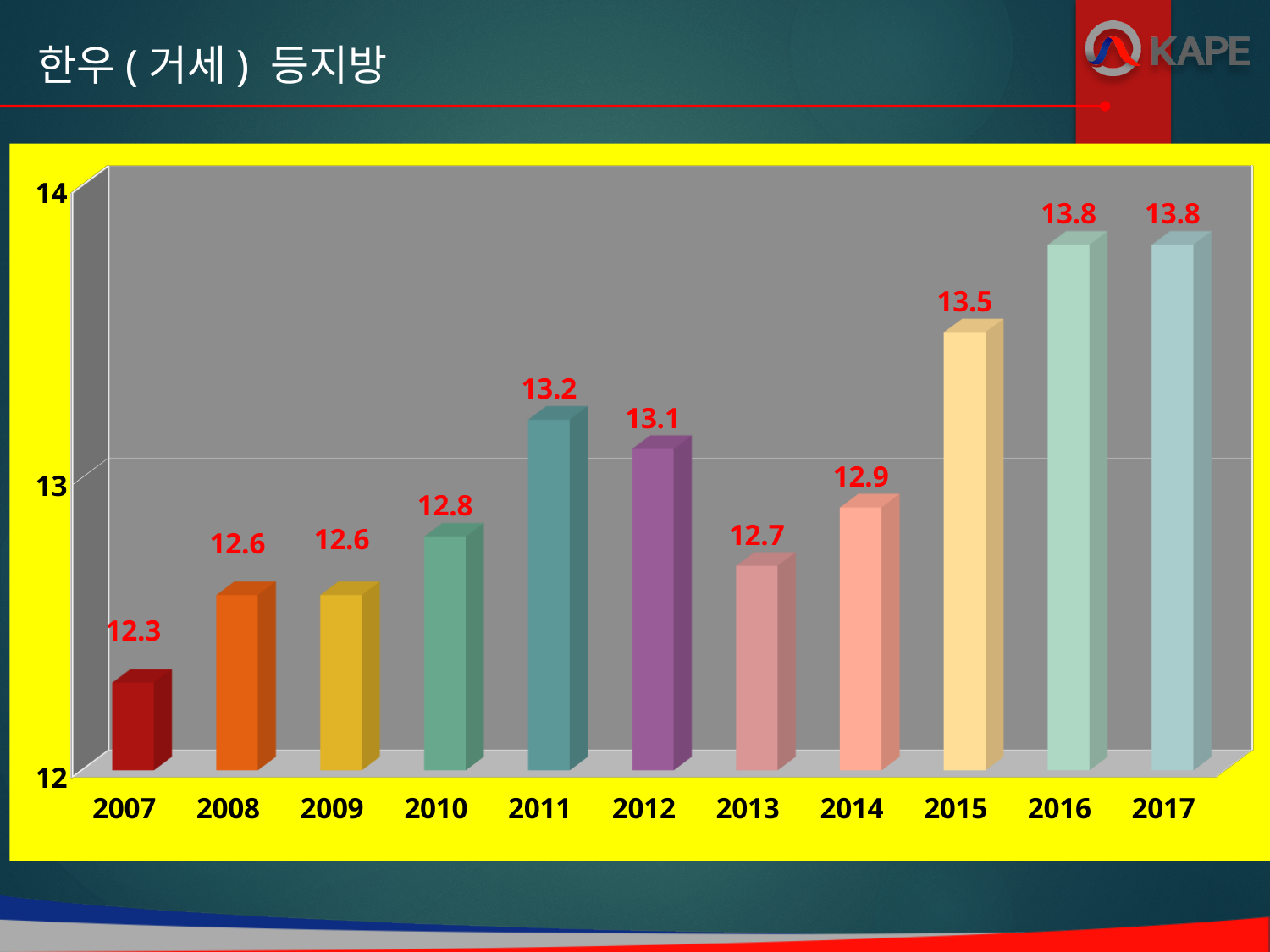
Which is larger, the value for 2011 or the value for 2014? 2011 What is the value for 2015? 13.5 What is the difference between the values for 2017 and 2007? 1.5 What is the title of the chart? 한우 ( 거세 ) 등지방 Which year has the lowest value? 2007 What is the value for 2012? 13.1 What kind of chart is shown on the slide? bar chart Do the values generally rise or fall from 2013 to 2017? rise How many years are shown on the x axis? 11 What is the value for 2007? 12.3 Is the value for 2010 greater or less than 13? less What is the difference between the values for 2011 and 2013? 0.5